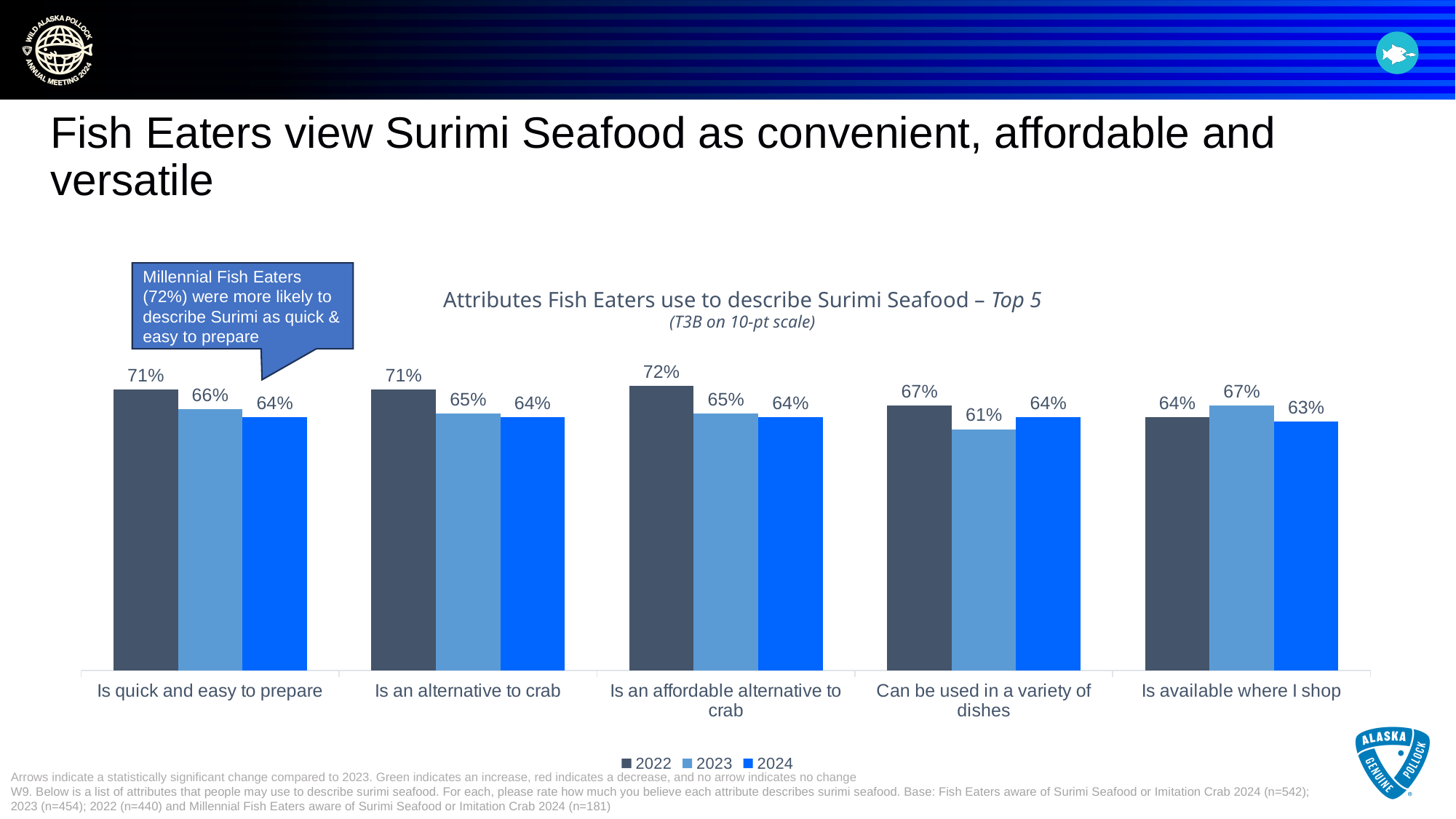
What is the 2023 value for 'Can be used in a variety of dishes'? 61% Which attribute has the highest 2022 value? Is an affordable alternative to crab How many attributes are shown on the chart? 5 What is the 2022 value for 'Is an affordable alternative to crab'? 72% Which attribute has the lowest 2023 value? Can be used in a variety of dishes What is the 2023 value for 'Is available where I shop'? 67% What is the 2024 value for 'Is quick and easy to prepare'? 64% What is the difference between the 2022 and 2024 values for 'Is an affordable alternative to crab'? 8% How many series does the legend list? 3 What kind of chart is shown on the slide? Bar chart What is the title of the chart? Attributes Fish Eaters use to describe Surimi Seafood – Top 5 For 'Is available where I shop', which year has the larger value, 2022 or 2023? 2023